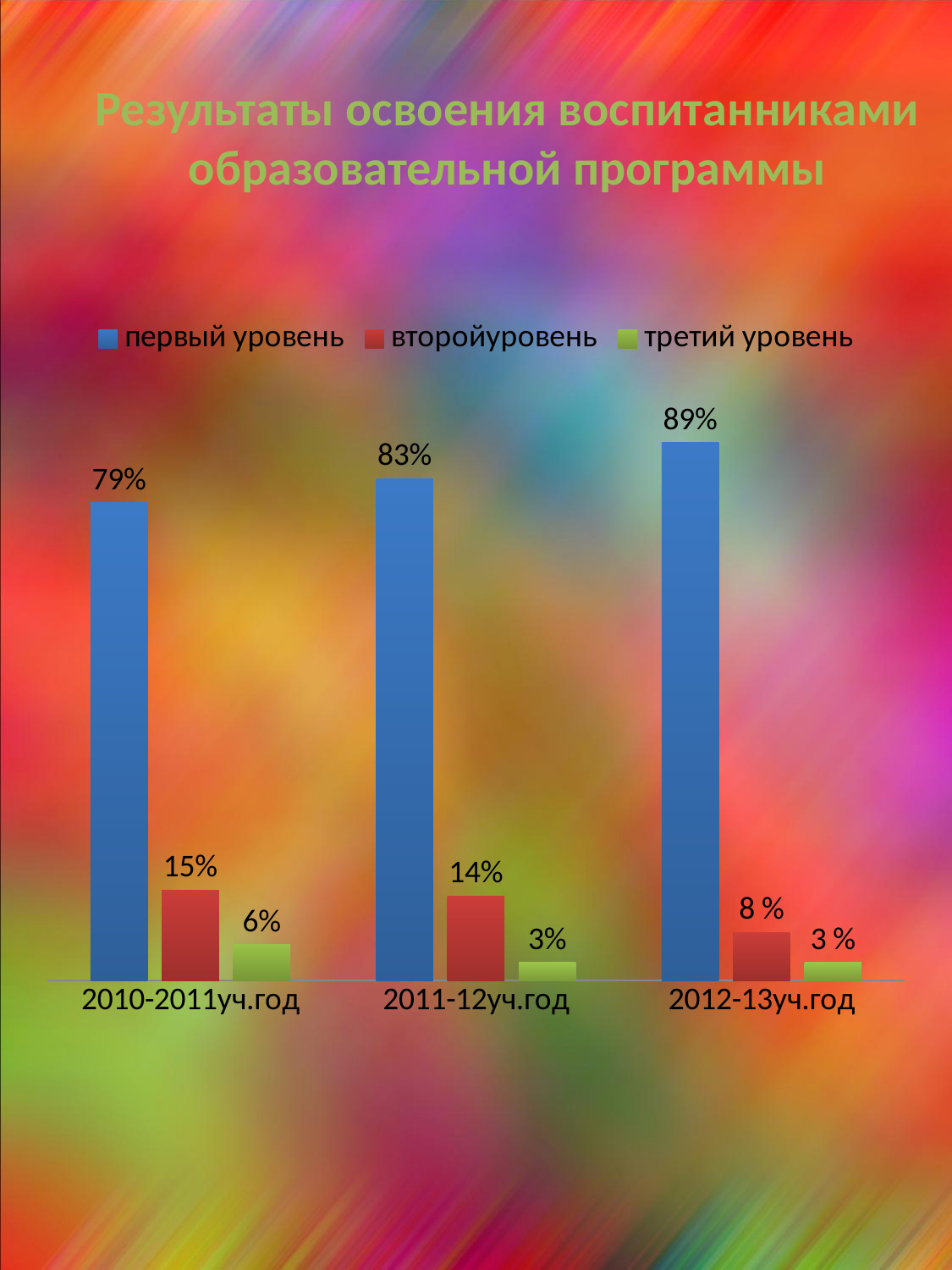
In which year is the value for второйуровень lowest? 2012-13уч.год What is the value for третий уровень in 2012-13уч.год? 3 % What is the difference between the первый уровень values for 2012-13уч.год and 2010-2011уч.год? 10% How many series does the legend list? 3 What is the value for второйуровень in 2012-13уч.год? 8 % Which is larger: третий уровень in 2010-2011уч.год or третий уровень in 2011-12уч.год? 2010-2011уч.год What is the value for второйуровень in 2011-12уч.год? 14% What kind of chart is shown on the slide? bar chart Does the value for первый уровень rise or fall from 2010-2011уч.год to 2012-13уч.год? rise How many year categories are shown on the x axis? 3 What is the value for первый уровень in 2010-2011уч.год? 79% In which year is the value for первый уровень highest? 2012-13уч.год